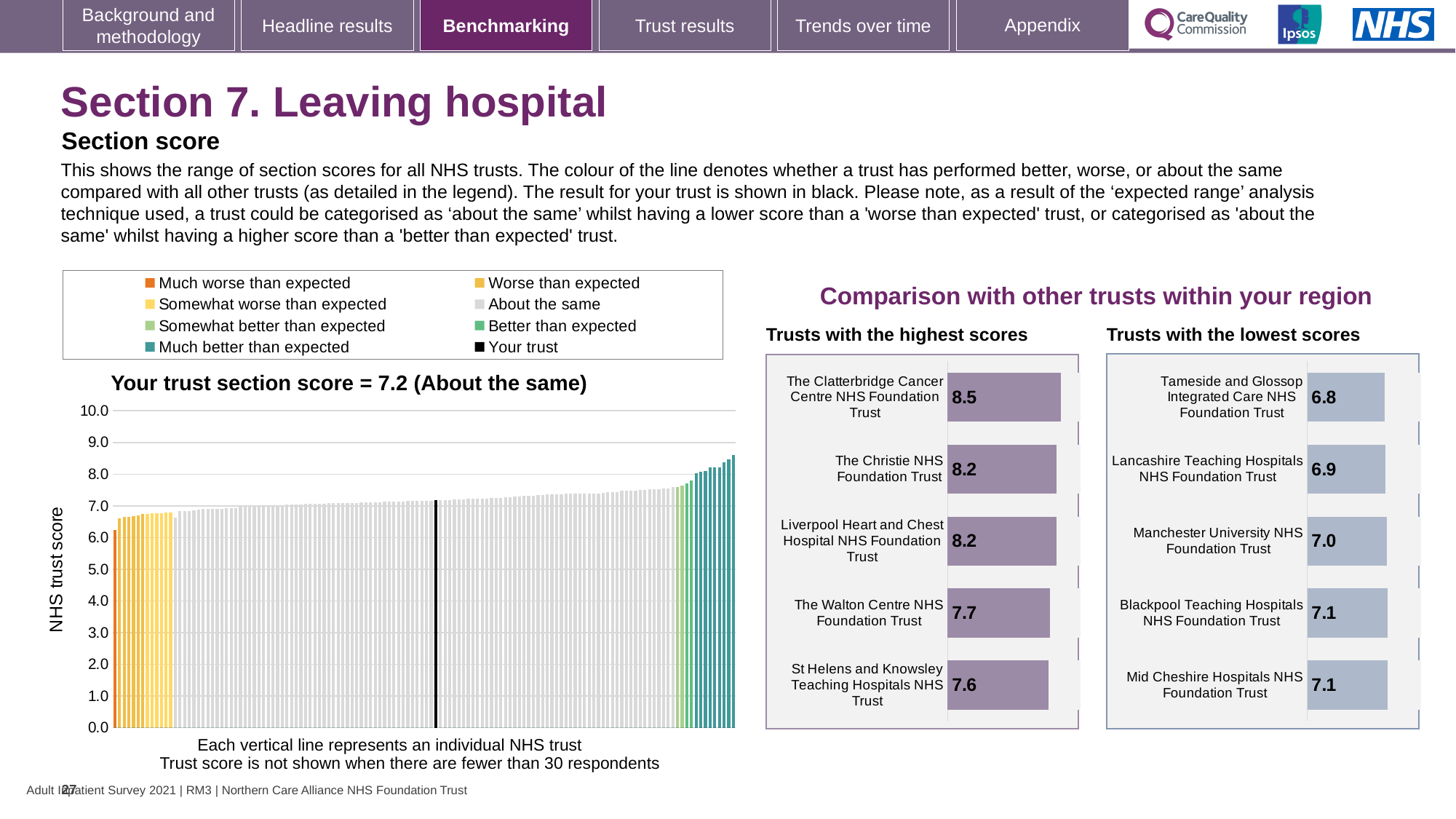
How many trusts are shown in the 'Trusts with the highest scores' chart? 5 In the 'Trusts with the lowest scores' chart, which trust has the lowest score? Tameside and Glossop Integrated Care NHS Foundation Trust According to the main chart on the left, what is your trust's section score? 7.2 In the 'Trusts with the lowest scores' chart, what is the score for Tameside and Glossop Integrated Care NHS Foundation Trust? 6.8 In the 'Trusts with the highest scores' chart, what is the difference between the scores of The Clatterbridge Cancer Centre NHS Foundation Trust and St Helens and Knowsley Teaching Hospitals NHS Trust? 0.9 In the main chart on the left, is the value of the tallest bar greater or less than 8.0? greater How many entries does the legend above the main chart on the left list? 8 In the 'Trusts with the highest scores' chart, which trust has the highest score? The Clatterbridge Cancer Centre NHS Foundation Trust In the 'Trusts with the lowest scores' chart, which has the larger score: Lancashire Teaching Hospitals NHS Foundation Trust or Blackpool Teaching Hospitals NHS Foundation Trust? Blackpool Teaching Hospitals NHS Foundation Trust In the 'Trusts with the highest scores' chart, what is the score for The Walton Centre NHS Foundation Trust? 7.7 In the 'Trusts with the highest scores' chart, what is the score for The Clatterbridge Cancer Centre NHS Foundation Trust? 8.5 In the 'Trusts with the lowest scores' chart, what is the score for Manchester University NHS Foundation Trust? 7.0